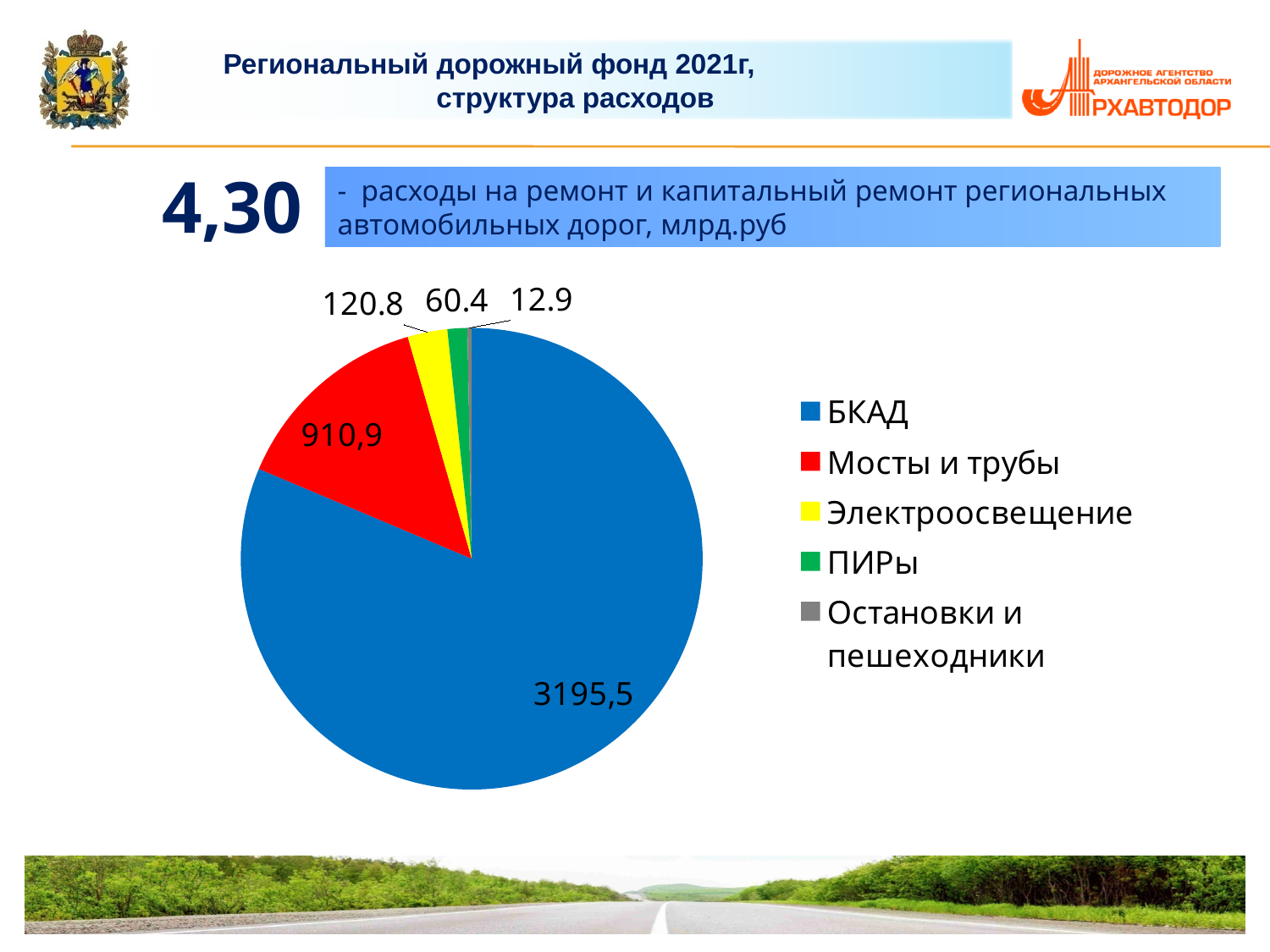
How many categories does the pie chart show? 5 What is the difference between the values for БКАД and Мосты и трубы? 2284,6 Which category has the smallest slice in the pie chart? Остановки и пешеходники What is the value for ПИРы in the pie chart? 60.4 Which category has the largest slice in the pie chart? БКАД What is the value for БКАД in the pie chart? 3195,5 What is the value for Электроосвещение in the pie chart? 120.8 What is the value for Остановки и пешеходники in the pie chart? 12.9 What is the difference between the values for Электроосвещение and ПИРы? 60.4 Which is larger, the value for Мосты и трубы or the value for Электроосвещение? Мосты и трубы What is the value for Мосты и трубы in the pie chart? 910,9 What type of chart is shown on the slide? Pie chart